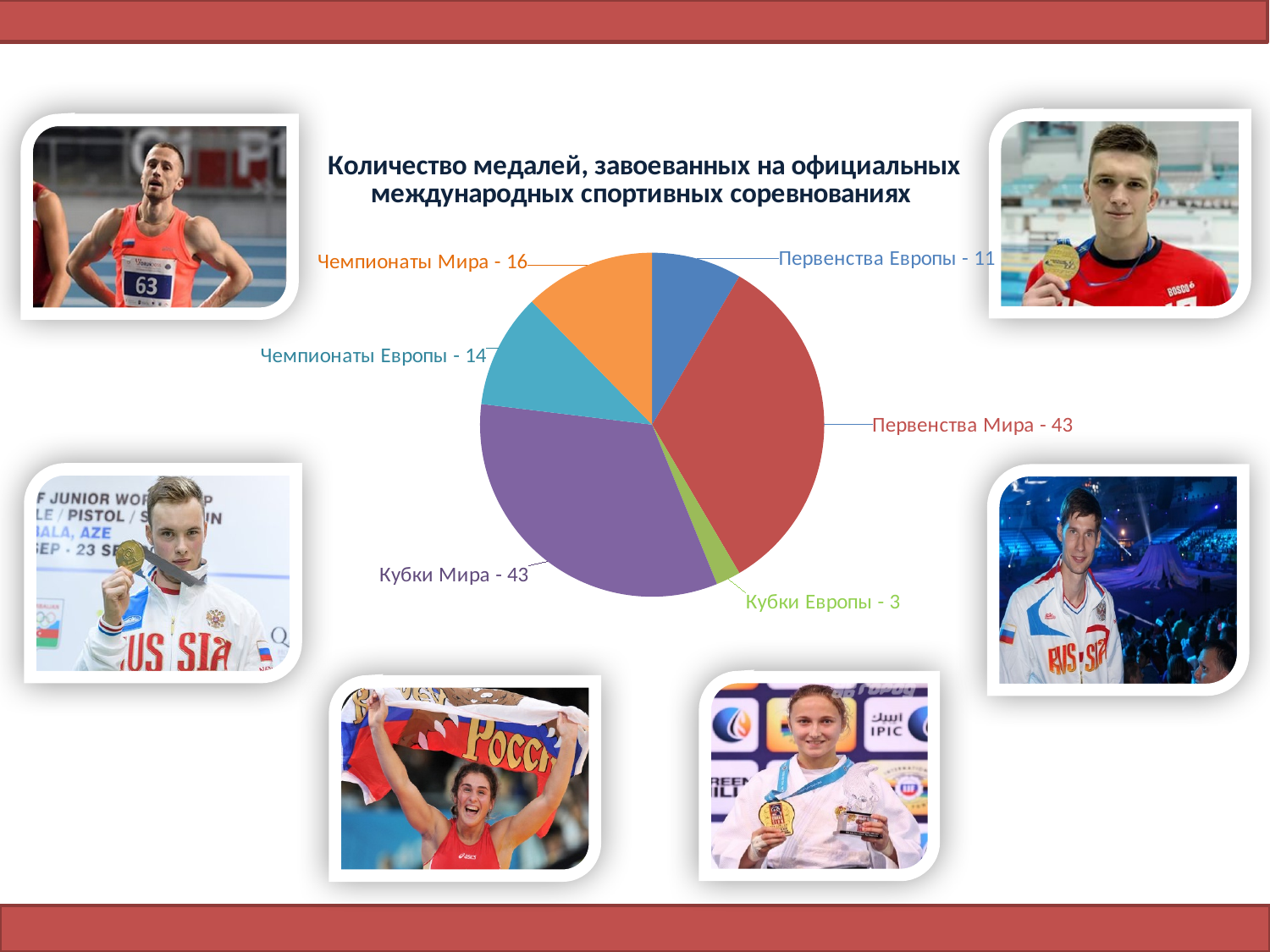
Which is larger: the number of medals at Чемпионаты Мира or at Первенства Европы? Чемпионаты Мира How many categories (slices) does the pie chart have? 6 What colour is the slice for Кубки Мира? Purple How many medals were won at Первенства Мира? 43 What is the total number of medals across all categories in the pie chart? 130 How many medals were won at Чемпионаты Европы? 14 What type of chart is shown on the slide? Pie chart How many medals were won at Первенства Европы? 11 What is the title of the chart? Количество медалей, завоеванных на официальных международных спортивных соревнованиях How many medals were won at Кубки Европы? 3 Which category has the smallest number of medals? Кубки Европы What is the difference between the medals won at Чемпионаты Мира and Чемпионаты Европы? 2